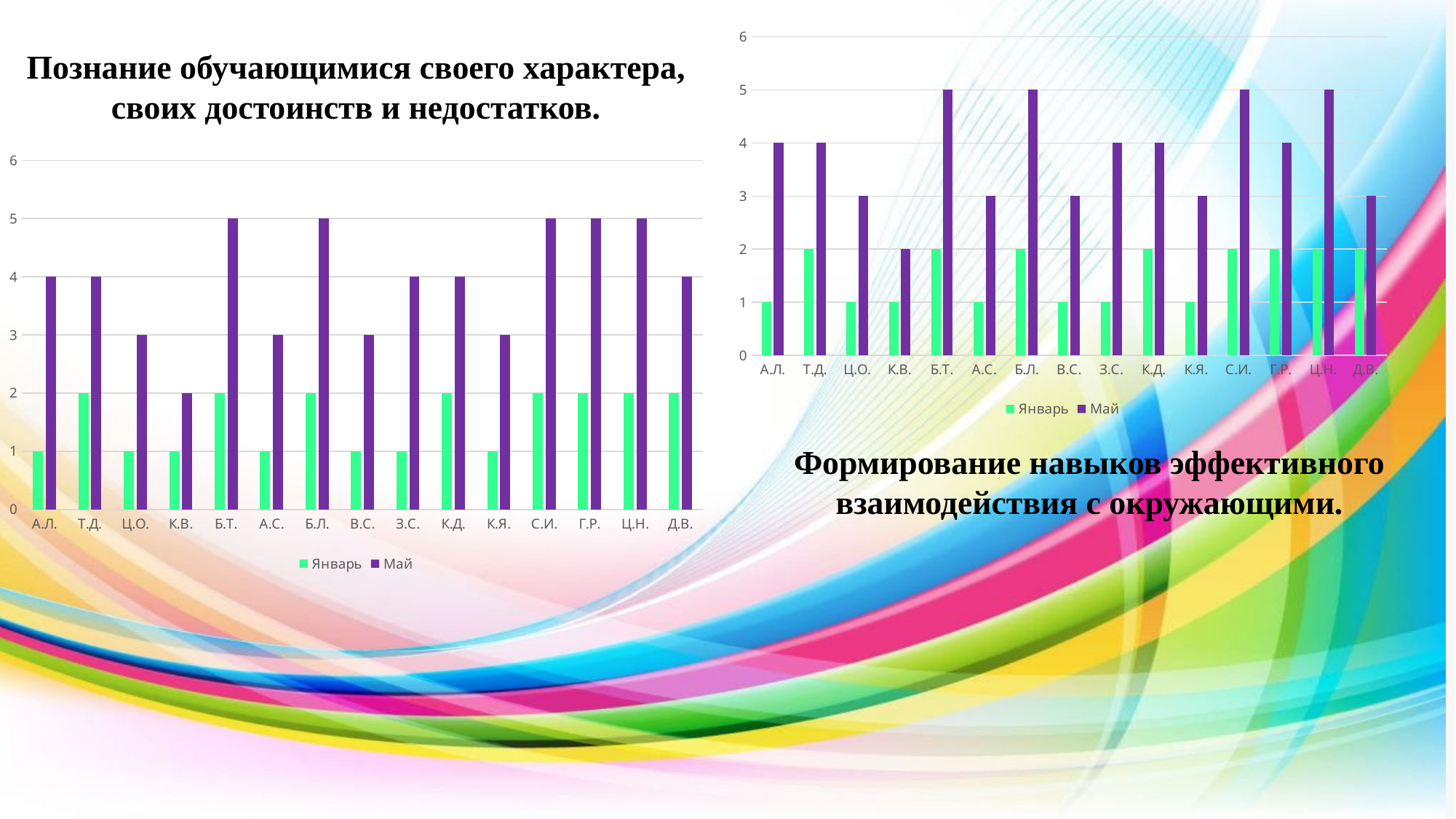
On the left chart (Познание обучающимися своего характера...), what is the value for Май for К.В.? 2 On the right chart (Формирование навыков эффективного взаимодействия...), which is larger for Ц.О.: the Январь value or the Май value? Май On the left chart (Познание обучающимися своего характера...), which category has the lowest Май value? К.В. On the right chart (Формирование навыков эффективного взаимодействия...), what is the value for Май for Д.В.? 3 On the left chart (Познание обучающимися своего характера...), how many series does the legend list? 2 What kind of chart is the right chart (Формирование навыков эффективного взаимодействия...)? bar chart On the left chart (Познание обучающимися своего характера...), how many categories are shown on the x axis? 15 On the right chart (Формирование навыков эффективного взаимодействия...), what is the value for Май for Г.Р.? 4 On the right chart (Формирование навыков эффективного взаимодействия...), what are the two series listed in the legend? Январь and Май On the left chart (Познание обучающимися своего характера...), what is the difference between the Май and Январь values for А.Л.? 3 On the left chart (Познание обучающимися своего характера...), what is the value for Январь for Б.Т.? 2 On the right chart (Формирование навыков эффективного взаимодействия...), which category has the lowest Май value? К.В.